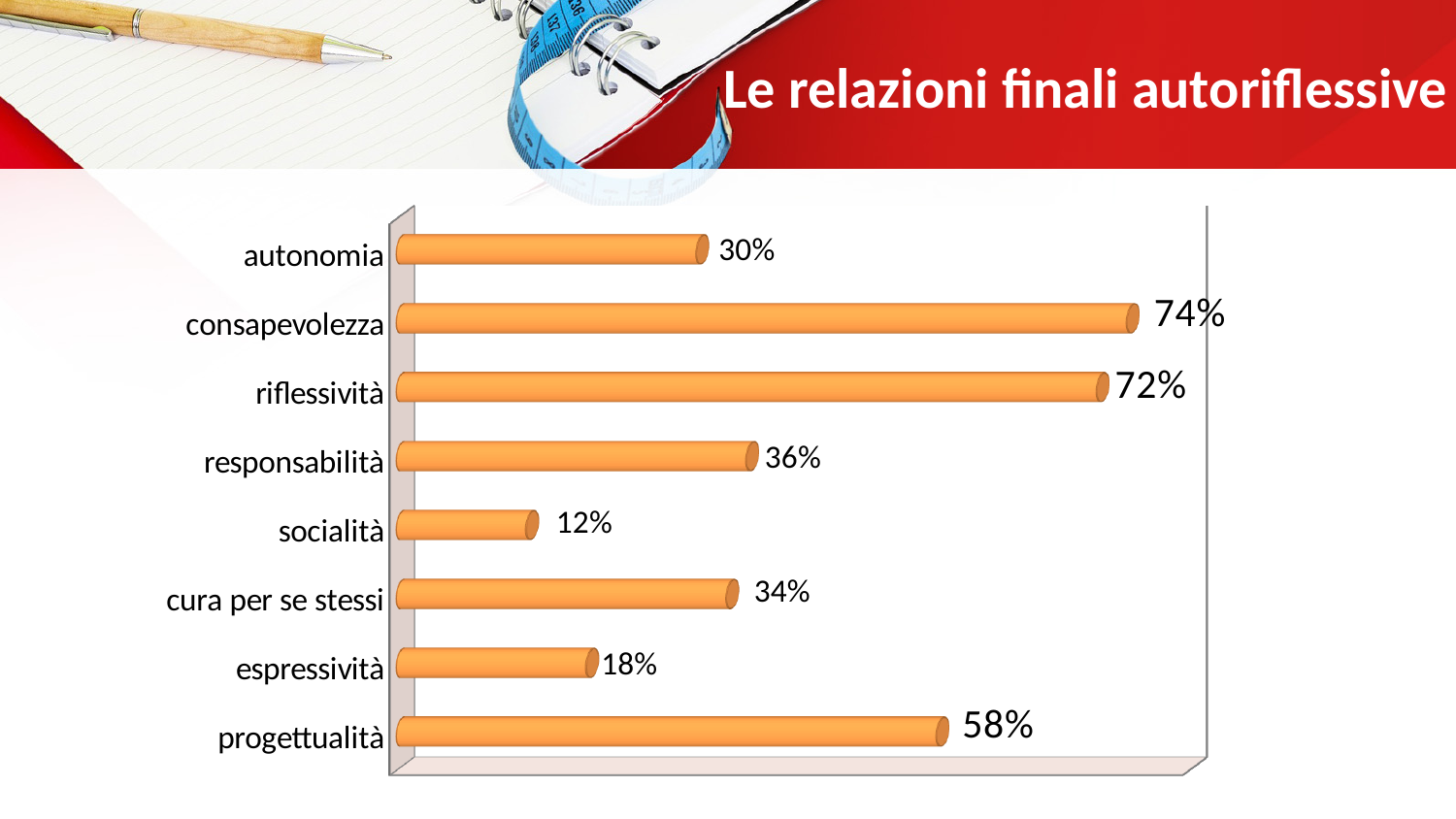
What is the value for socialità? 12% What is the difference between the values for progettualità and autonomia? 28% What kind of chart is shown on the slide? bar chart What is the value for consapevolezza? 74% Which category has the highest value? consapevolezza Which category has the lowest value? socialità Which is larger, the value for responsabilità or the value for cura per se stessi? responsabilità What is the title of the slide containing the chart? Le relazioni finali autoriflessive What is the value for progettualità? 58% How many categories are shown in the chart? 8 What is the value for cura per se stessi? 34% What is the difference between the values for consapevolezza and riflessività? 2%